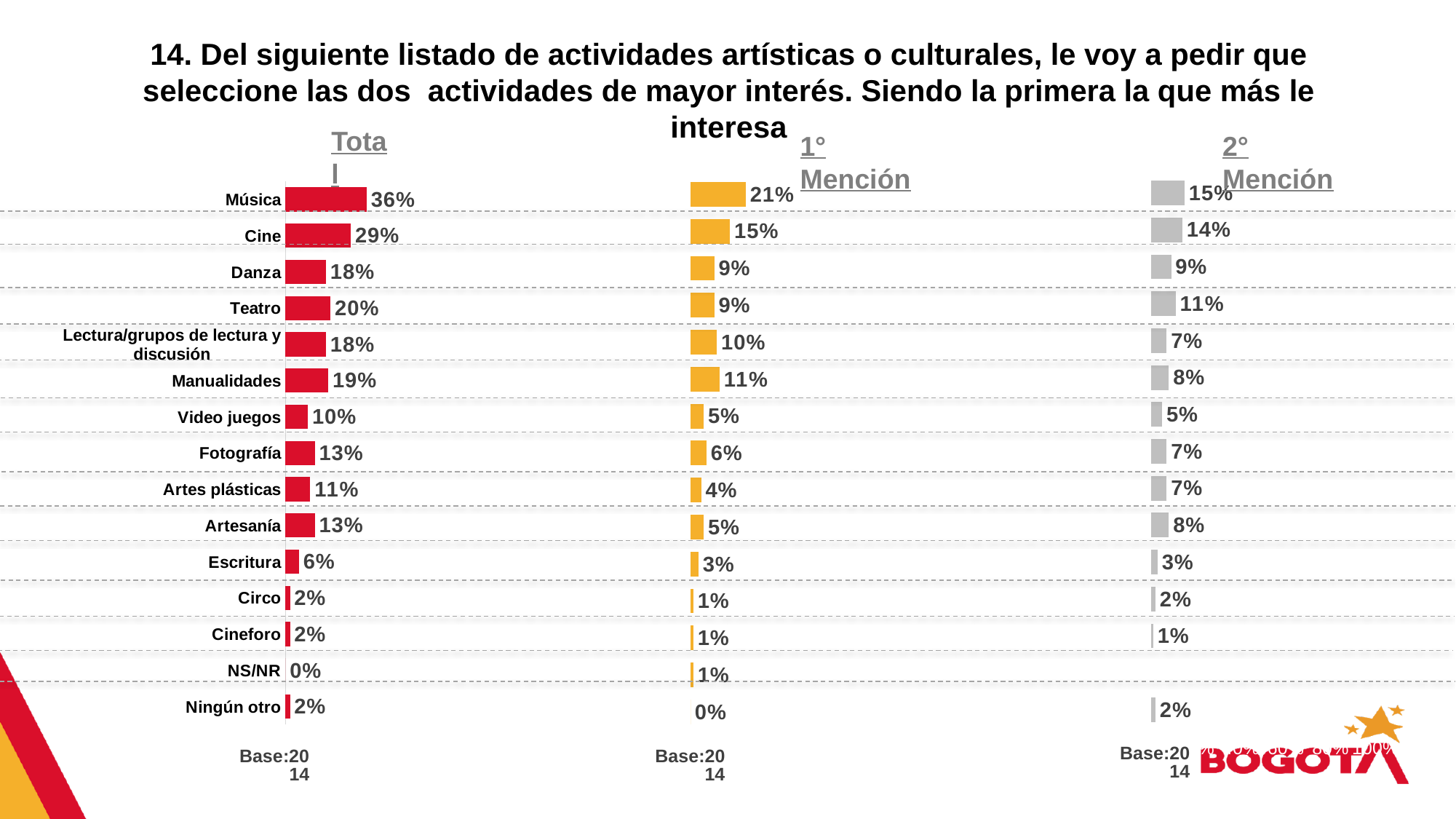
How many categories are listed in the Total chart? 15 In the Total chart, what is the value for Música? 36% What kind of chart is the Total chart? Bar chart In the 2° Mención chart, which is larger, Música or Cine? Música In the 2° Mención chart, what is the value for Teatro? 11% In the Total chart, which is larger, Teatro or Danza? Teatro In the Total chart, which category has the highest value? Música In the 1° Mención chart, what is the value for Cine? 15% In the 2° Mención chart, what is the difference between Artesanía and Escritura? 5% In the 1° Mención chart, what is the value for Manualidades? 11% In the Total chart, what is the difference between Música and Cine? 7%